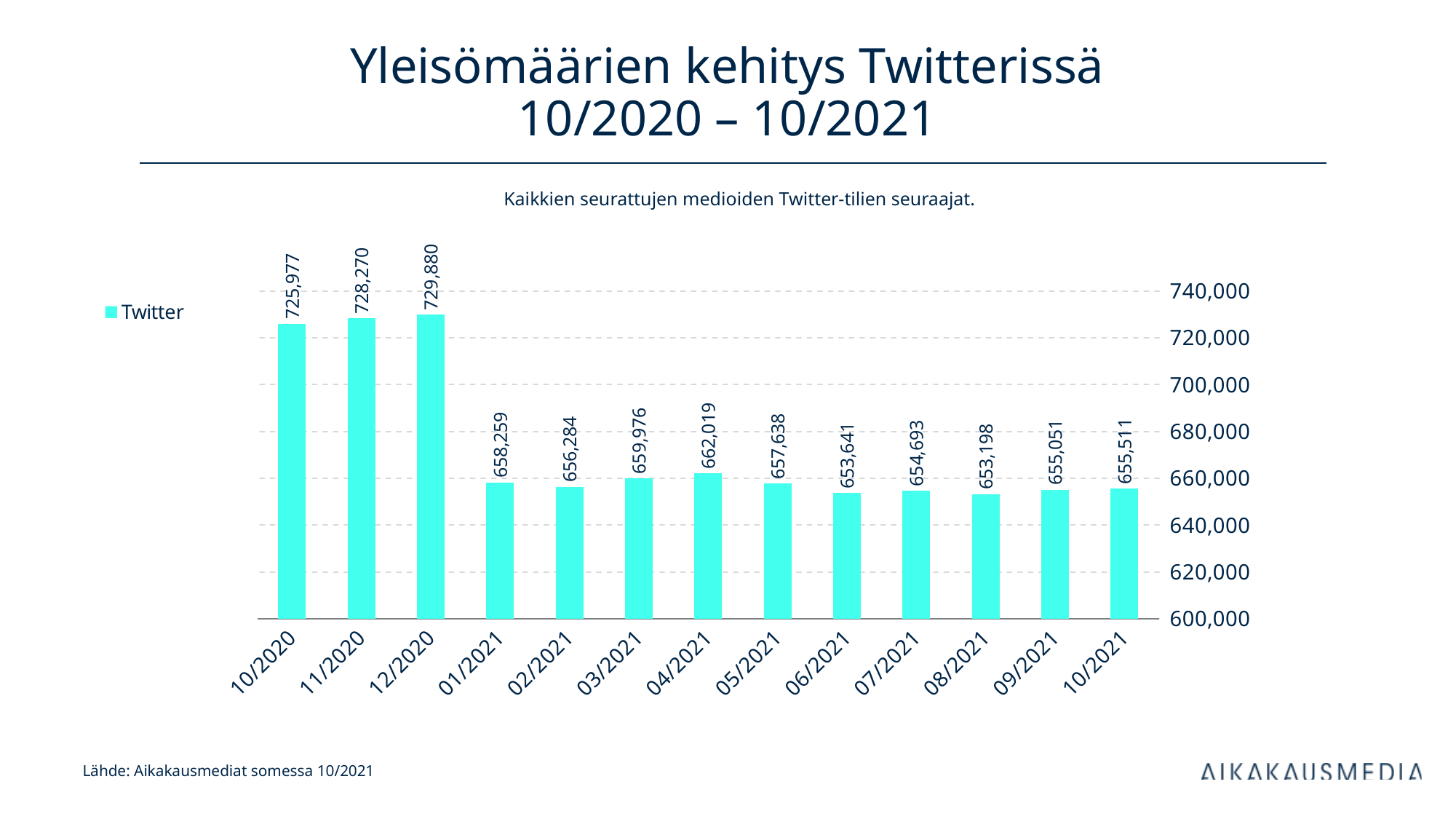
What kind of chart is shown on the slide? bar chart What is the value for 04/2021? 662,019 What is the value for 10/2021? 655,511 How many months are shown on the x axis? 13 Which month has the highest value? 12/2020 What is the difference between the values for 12/2020 and 01/2021? 71,621 Which month has the lowest value? 08/2021 Which is larger, the value for 03/2021 or the value for 06/2021? 03/2021 How many series does the legend list? 1 What is the value for 10/2020? 725,977 Is the value for 11/2020 greater or less than 700,000? greater What is the difference between the values for 10/2020 and 10/2021? 70,466